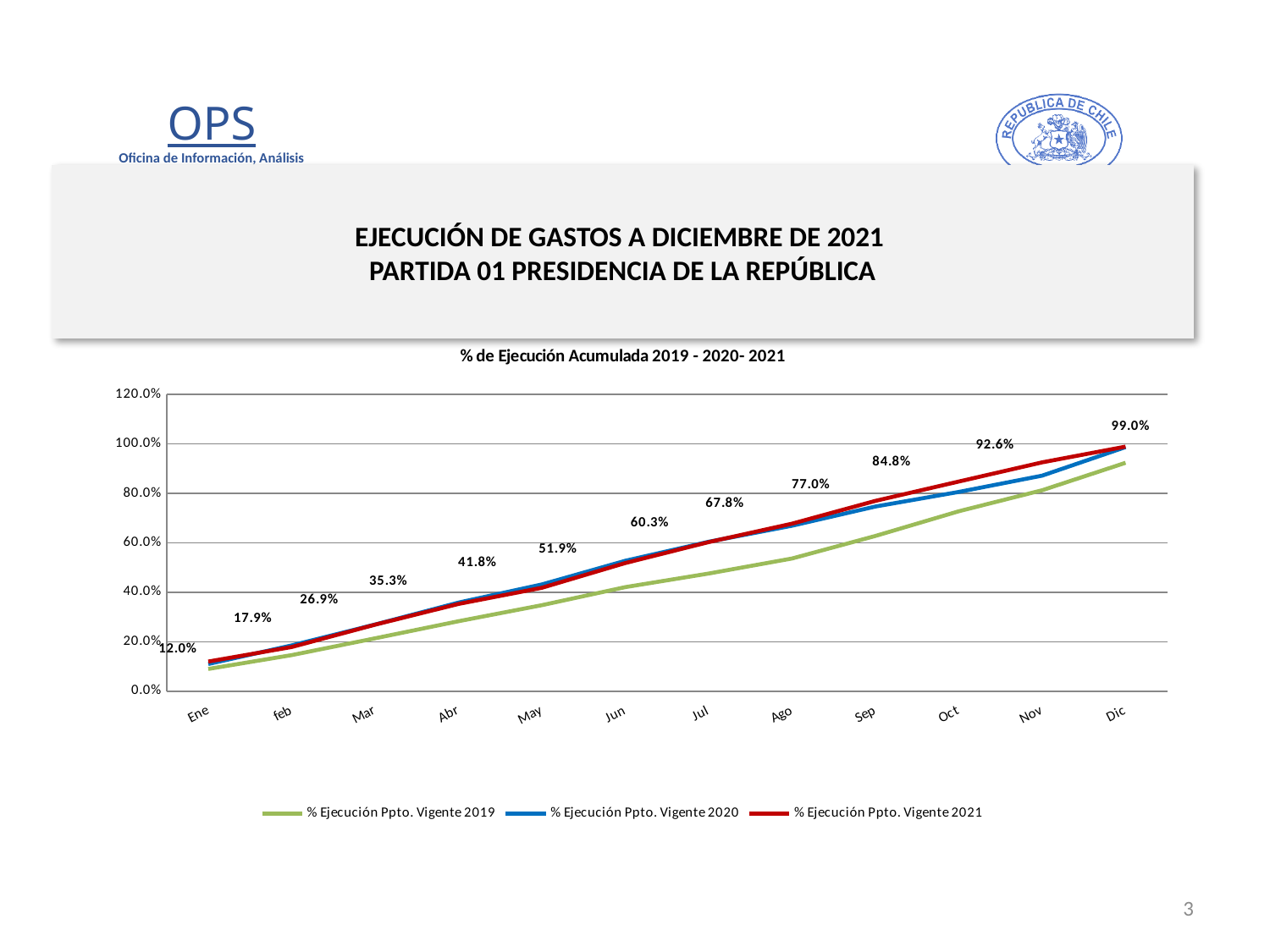
What is the labelled value for % Ejecución Ppto. Vigente 2021 in Jun? 51.9% How many months are plotted along the x axis? 12 What is the title of the chart? % de Ejecución Acumulada 2019 - 2020- 2021 Is the value for % Ejecución Ppto. Vigente 2019 in Sep greater or less than 80.0%? less Do the values of the series rise or fall from Ene to Dic? rise In which month is the labelled 2021 value the highest? Dic In which month is the labelled 2021 value the lowest? Ene How many series does the legend list? 3 What is the labelled value for % Ejecución Ppto. Vigente 2021 in Dic? 99.0% What kind of chart is shown on the slide? line chart What is the difference between the labelled 2021 values for Dic and Nov? 6.4% What is the labelled value for % Ejecución Ppto. Vigente 2021 in Ene? 12.0%